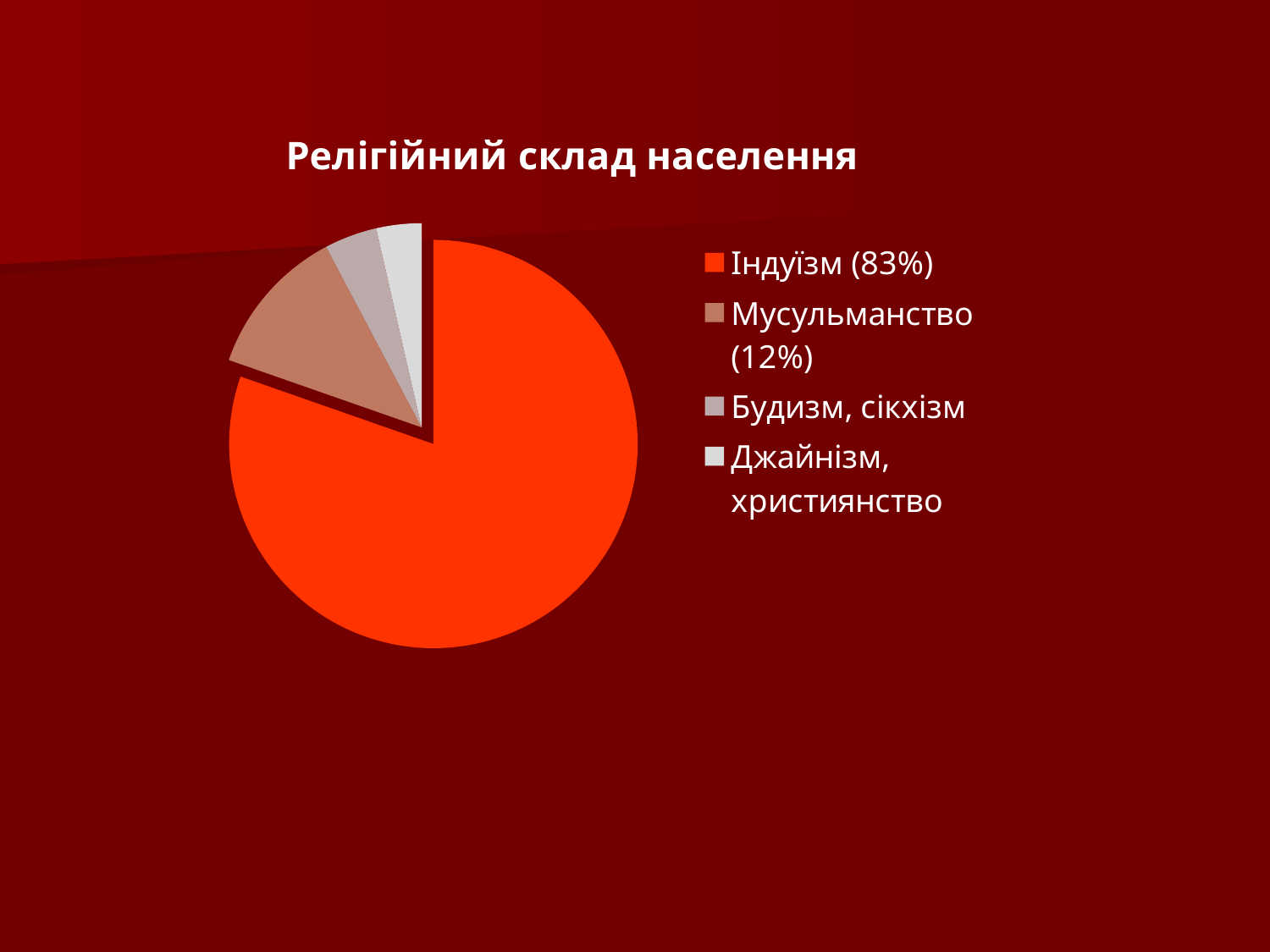
How many categories does the pie chart have? 4 What is the title of the chart? Релігійний склад населення What is the difference between the shares of Індуїзм and Мусульманство? 71% Which is larger, the share of Індуїзм or the share of Мусульманство? Індуїзм Which is larger, the share of Мусульманство or the share of Будизм, сікхізм? Мусульманство What share of the pie does Індуїзм have? 83% What kind of chart is shown on the slide? pie chart What share of the pie does Мусульманство have? 12% Which legend entry is shown in the bright orange-red colour? Індуїзм (83%) Which category has the largest share of the pie? Індуїзм